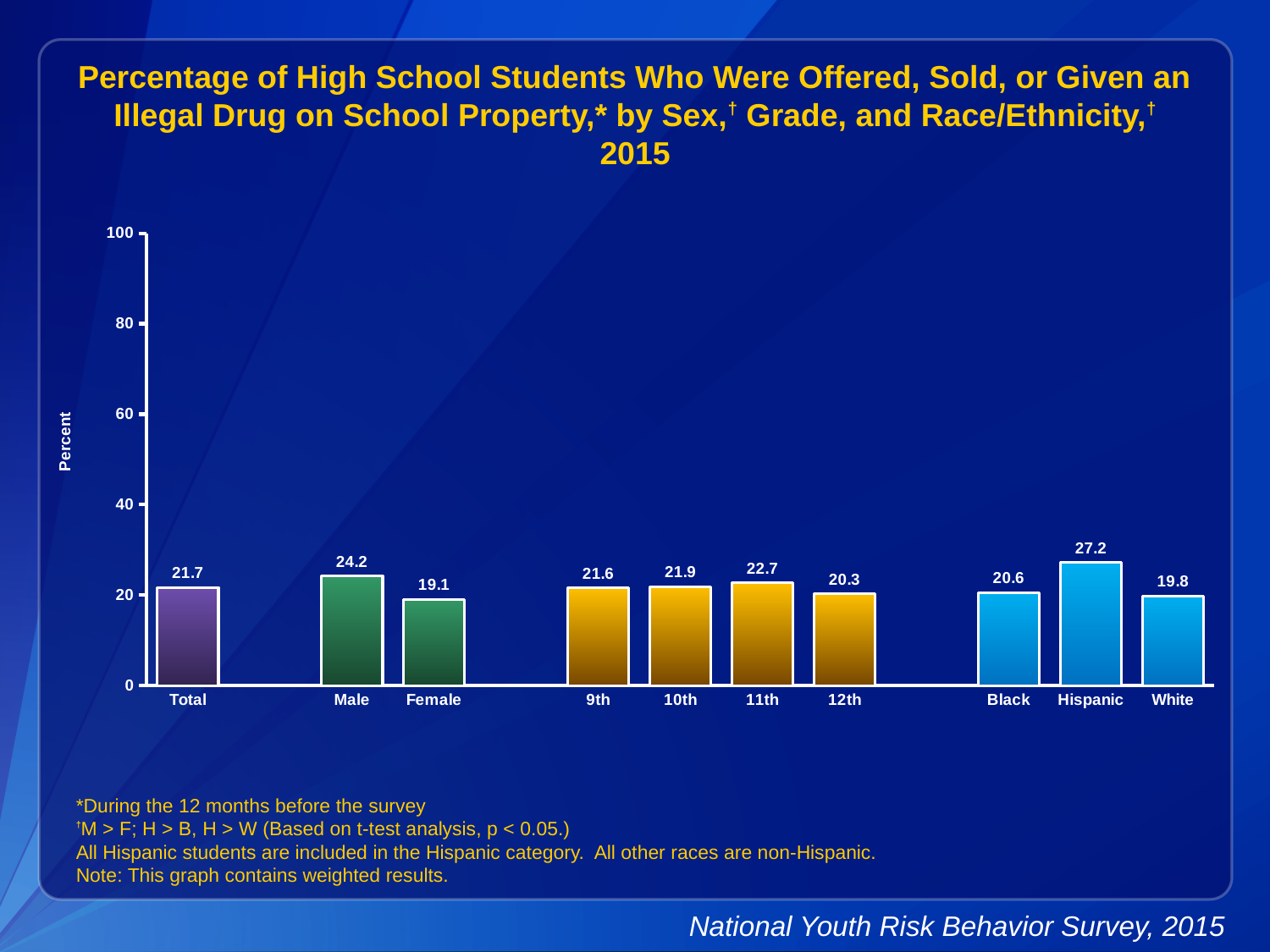
Which category has the highest value? Hispanic Is the value for 12th grade greater or less than 40? less How many categories are shown on the x axis? 10 What is the value for 11th grade? 22.7 What is the label on the y axis? Percent What is the value for Male? 24.2 Which category has the lowest value? Female What is the value for Hispanic students? 27.2 What is the difference between the Male and Female values? 5.1 Which is larger, the value for Black or the value for White? Black What kind of chart is this? bar chart What is the value for Total? 21.7